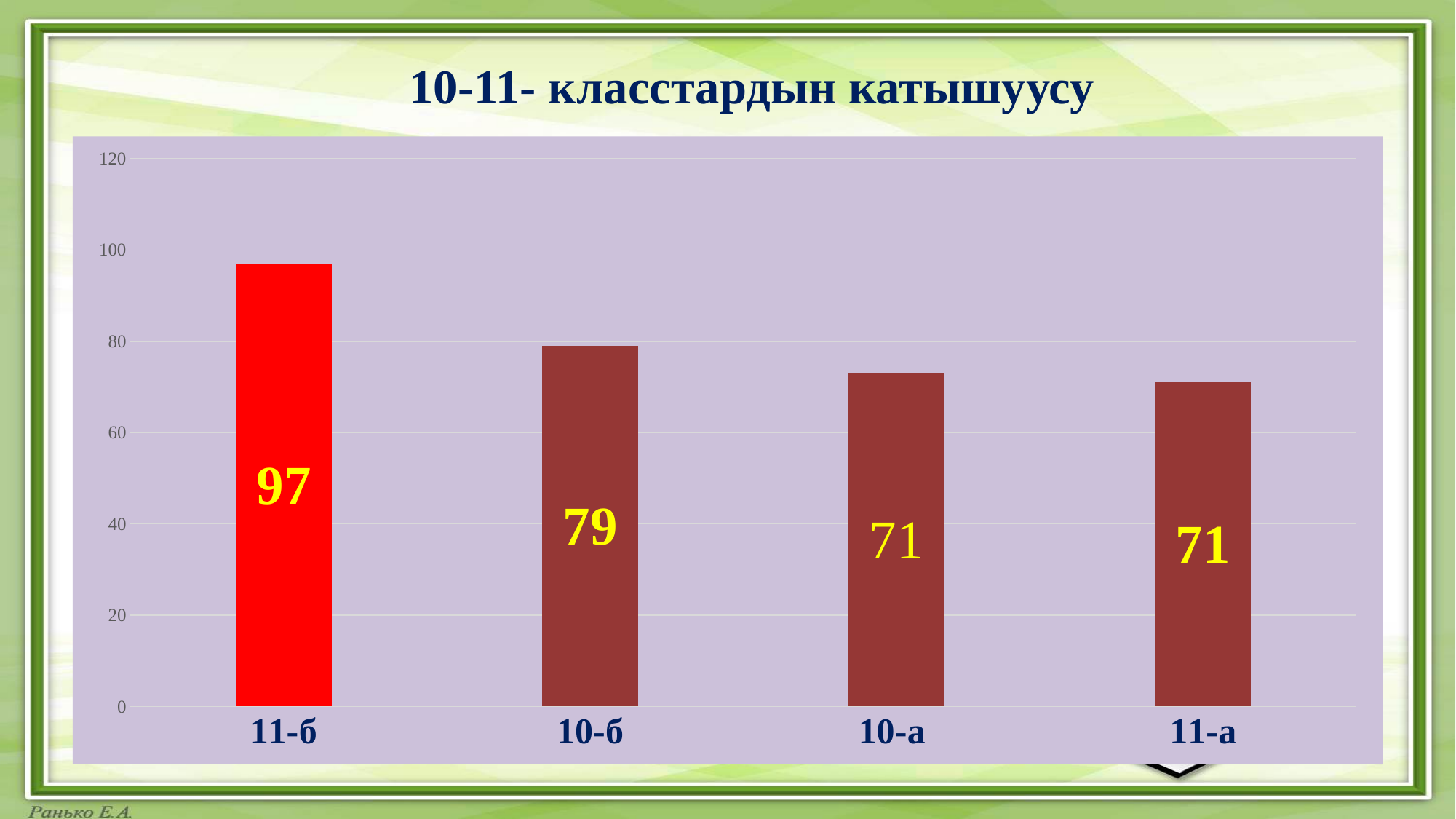
How many categories are shown on the x axis? 4 What is the value for 11-б? 97 Which is larger, the value for 11-б or the value for 10-а? 11-б What is the value for 10-а? 71 Which category has the highest value? 11-б What is the value for 10-б? 79 What is the value for 11-а? 71 What is the difference between the values for 10-б and 11-а? 8 What is the title of the chart? 10-11- класстардын катышуусу What kind of chart is shown on the slide? bar chart Is the value for 10-б greater or less than 100? less What is the difference between the values for 11-б and 10-б? 18